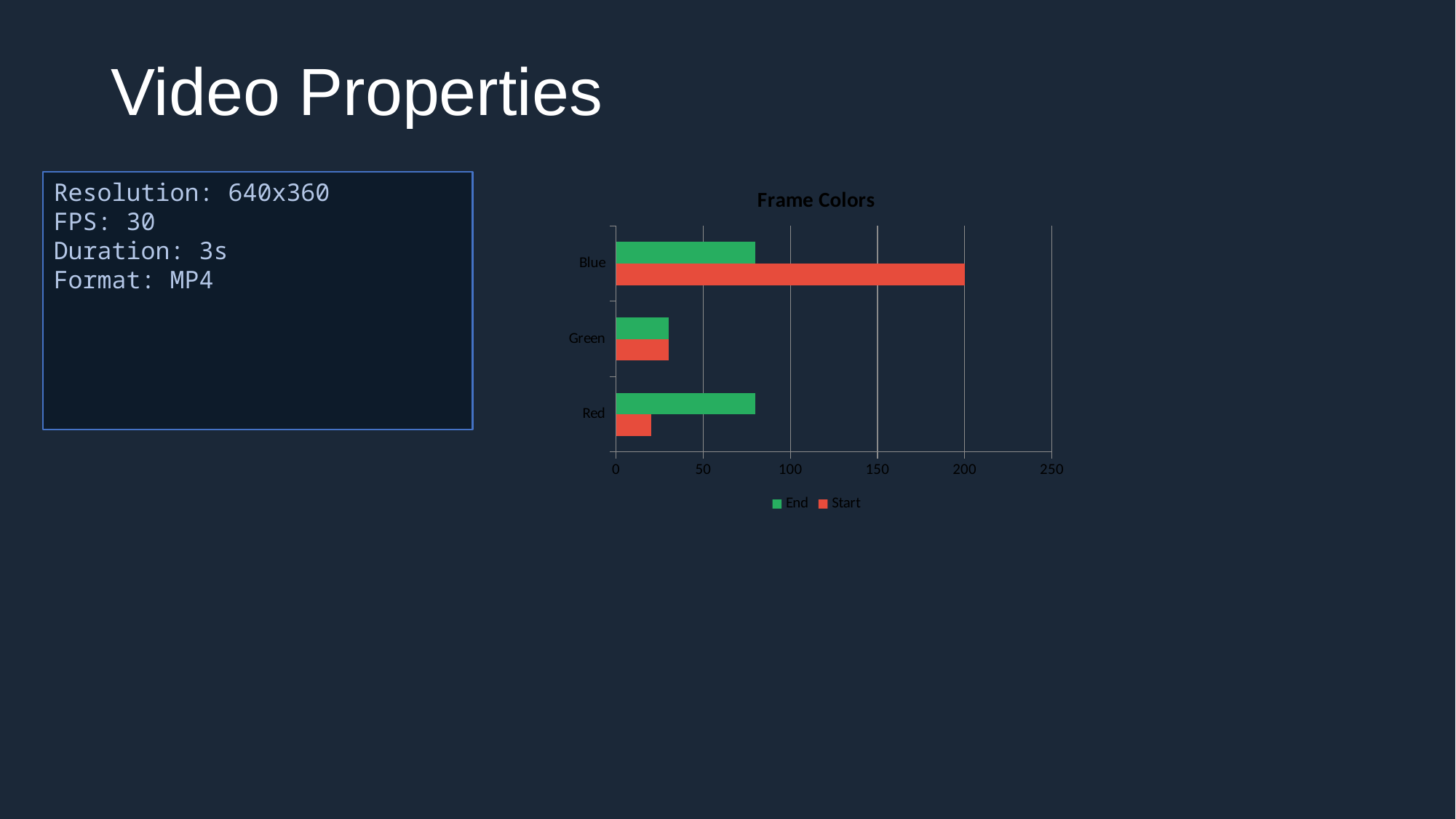
What type of chart is shown on the slide? bar chart Which category has the highest Start value? Blue Is the Start value for Red greater or less than 50? less For Blue, which is larger: the Start value or the End value? Start Which colour represents the End series in the legend? green For Red, which is larger: the Start value or the End value? End How many series does the chart legend list? 2 What is the Start value for Blue? 200 What is the title of the chart? Frame Colors How many categories are shown on the chart? 3 Which category has the lowest Start value? Red Is the End value for Blue greater or less than 100? less